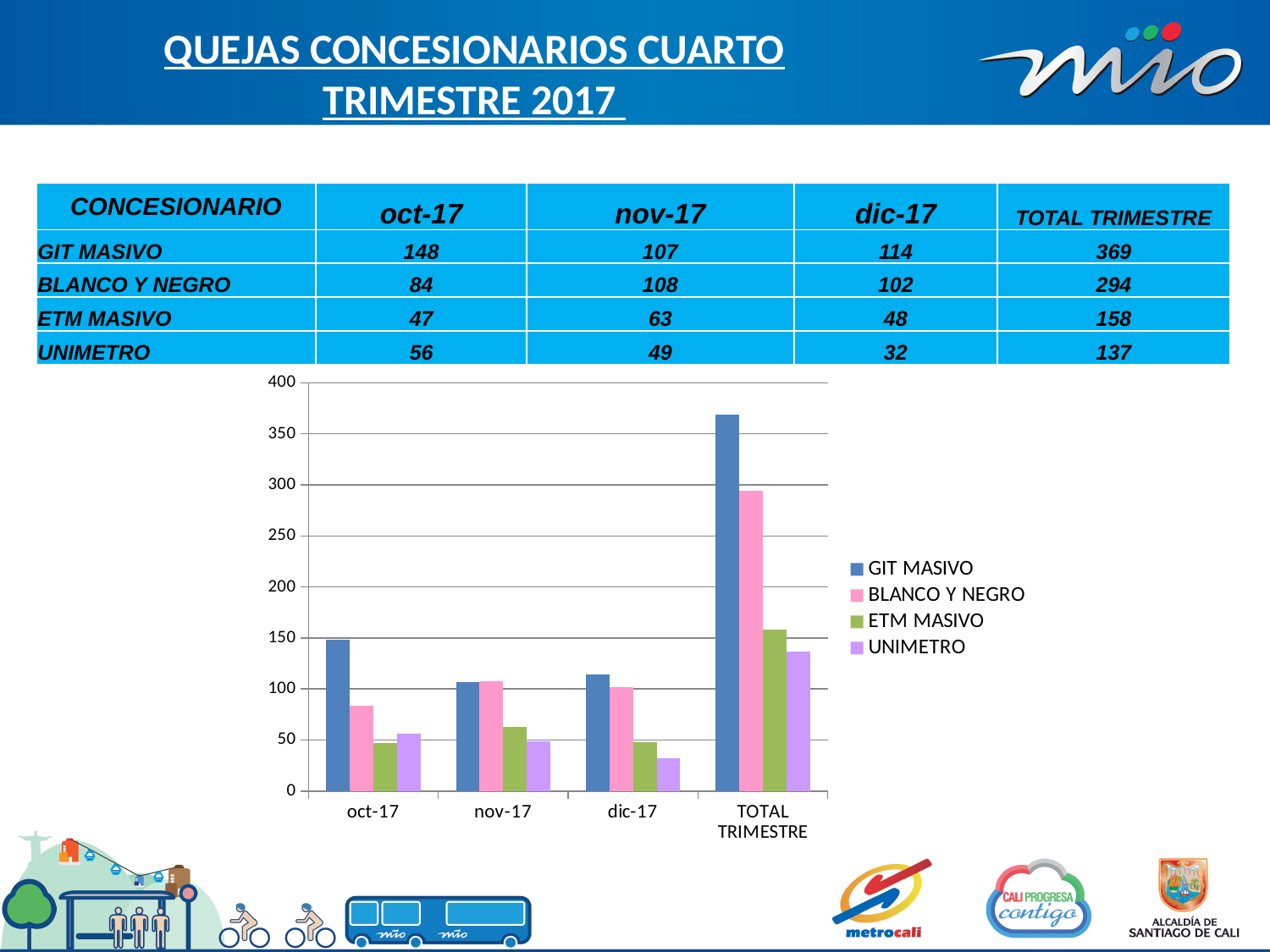
Is the TOTAL TRIMESTRE value for GIT MASIVO greater or less than 350? greater Does the value for UNIMETRO rise or fall from oct-17 to dic-17? fall What is the value for GIT MASIVO in oct-17? 148 How many categories are shown on the x axis of the chart? 4 Which series has the highest TOTAL TRIMESTRE value? GIT MASIVO What is the TOTAL TRIMESTRE value for BLANCO Y NEGRO? 294 How many series does the chart legend list? 4 What kind of chart is shown on the slide? bar chart What is the value for UNIMETRO in dic-17? 32 Which is larger in oct-17, GIT MASIVO or BLANCO Y NEGRO? GIT MASIVO Which series has the lowest value in dic-17? UNIMETRO What is the difference between the TOTAL TRIMESTRE values for GIT MASIVO and BLANCO Y NEGRO? 75